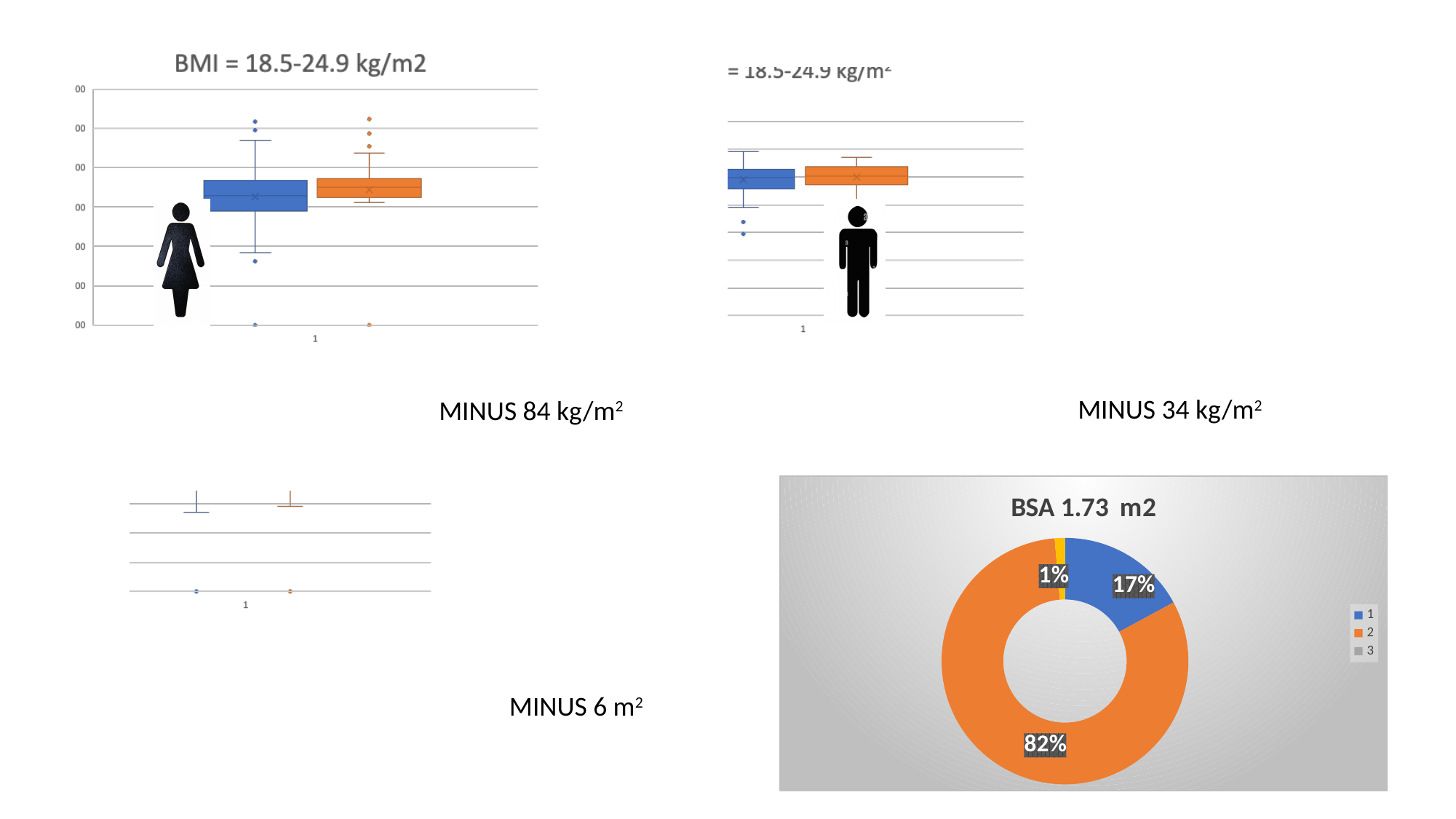
In the BSA 1.73 m2 chart, what percentage is shown for the smallest slice? 1% In the BSA 1.73 m2 chart, which legend entry corresponds to the largest slice? 2 In the BSA 1.73 m2 chart, what is the difference in percentage points between the 82% slice and the 17% slice? 65 How many entries does the legend of the BSA 1.73 m2 chart list? 3 What kind of chart is the top-left chart titled BMI = 18.5-24.9 kg/m2? box plot In the BSA 1.73 m2 chart, which is larger, the blue slice or the orange slice? the orange slice What kind of chart is the BSA 1.73 m2 chart? doughnut chart How many slices are labelled with percentages in the BSA 1.73 m2 chart? 3 In the BSA 1.73 m2 chart, what percentage is shown for the blue slice? 17% What is the title of the chart in the bottom-right of the slide? BSA 1.73 m2 In the BSA 1.73 m2 chart, what percentage is shown for the largest slice? 82%